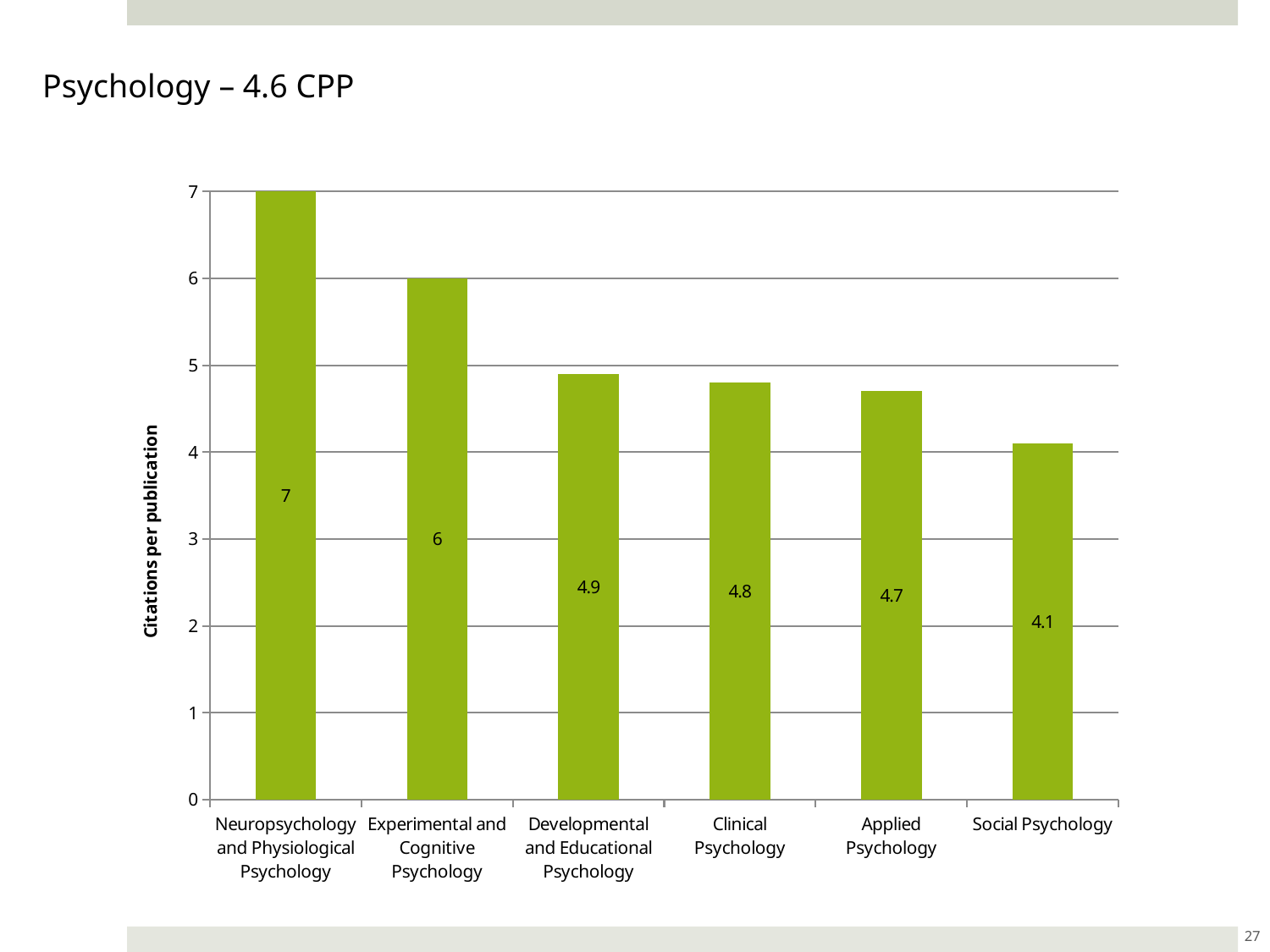
Which has a higher value, Experimental and Cognitive Psychology or Clinical Psychology? Experimental and Cognitive Psychology What is the citations per publication value for Social Psychology? 4.1 How many categories are shown on the chart? 6 What kind of chart is shown on the slide? Bar chart What is the difference between Developmental and Educational Psychology and Applied Psychology? 0.2 What is the difference in citations per publication between Neuropsychology and Physiological Psychology and Social Psychology? 2.9 What is the citations per publication value for Clinical Psychology? 4.8 What is the label of the vertical axis? Citations per publication Which category has the highest citations per publication? Neuropsychology and Physiological Psychology Which category has the lowest citations per publication? Social Psychology What is the value for Experimental and Cognitive Psychology? 6 Is the value for Applied Psychology greater or less than 5? less